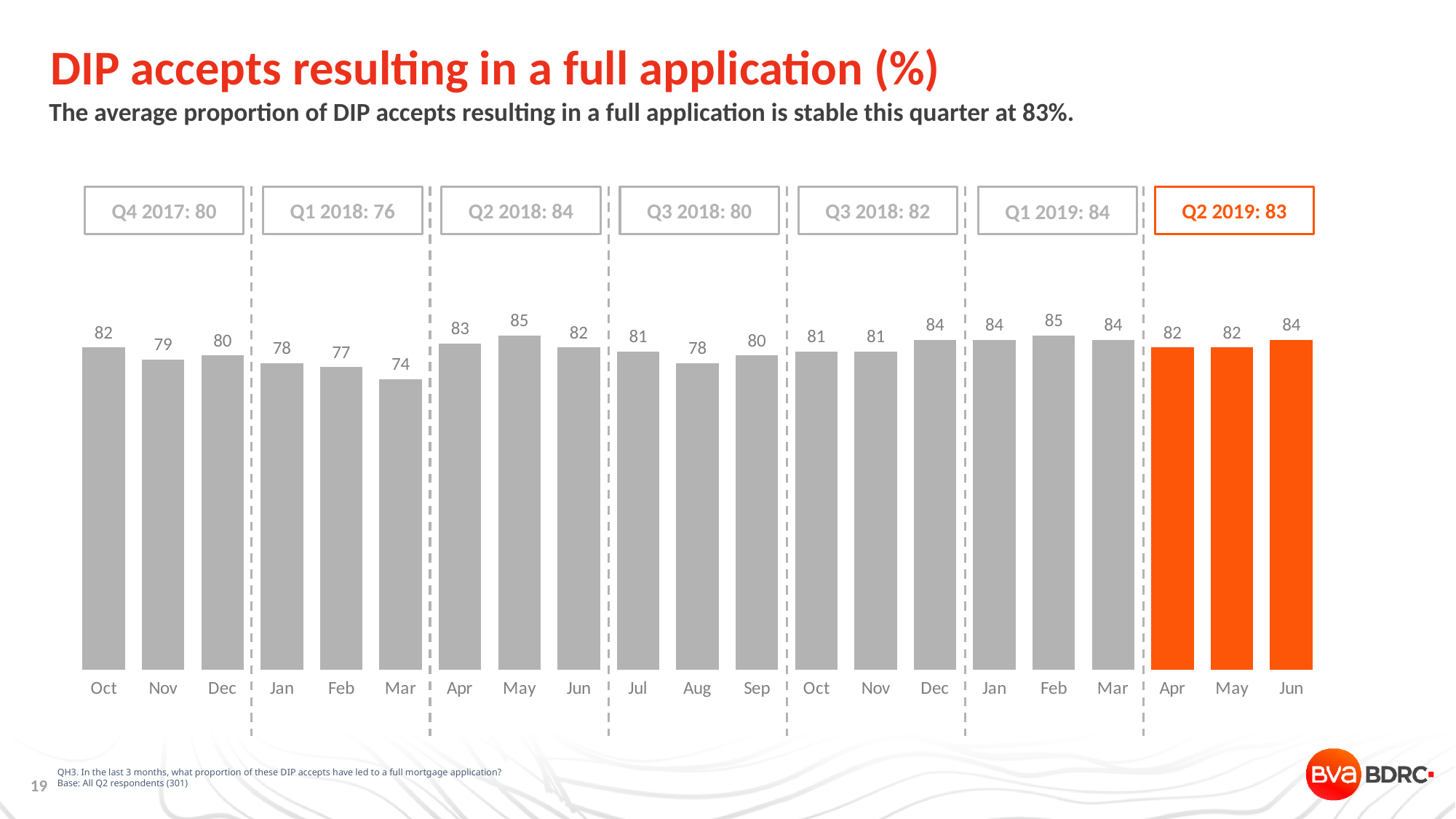
What is the value for Aug in the Q3 2018 section of the chart? 78 Which quarter's bars are coloured orange on the chart? Q2 2019 What is the difference between the value for Feb in Q1 2019 and the value for Feb in Q1 2018? 8 What is the value for Mar in the Q1 2018 section of the chart? 74 What is the difference between the values for May and Apr in the Q2 2018 section? 2 How many monthly bars are shown on the chart? 21 What kind of chart is shown on the slide? Bar chart What quarterly average is shown in the box for Q2 2019? 83 Which is larger: the value for Dec in Q4 2017 or the value for Dec in Q3 2018? Dec in Q3 2018 Do the values rise or fall from Jan to Mar within the Q1 2018 section? Fall Which month has the lowest value on the chart? Mar (Q1 2018), 74 What is the value for Jun in the Q2 2019 section of the chart? 84